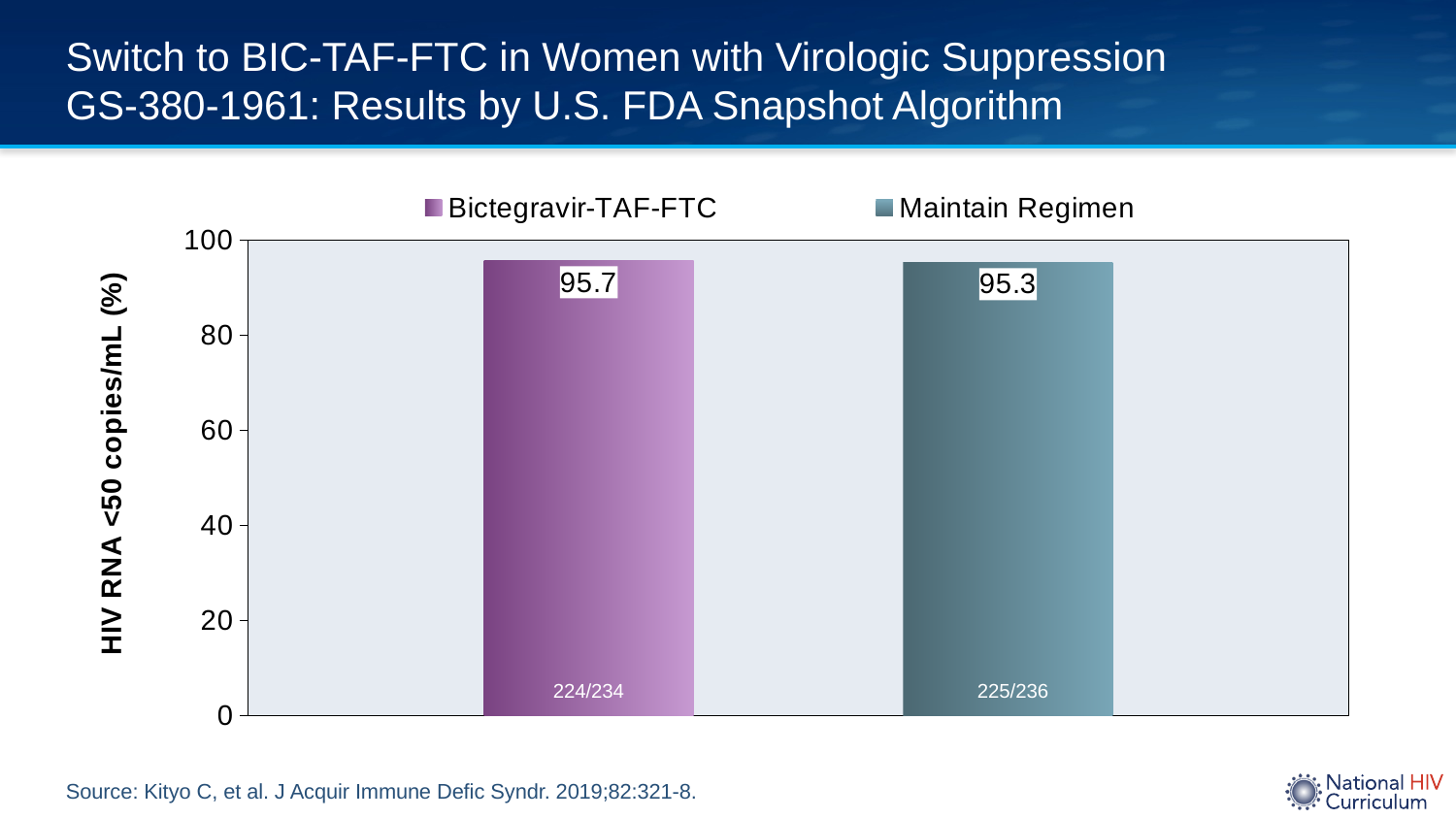
What fraction of participants is shown inside the Bictegravir-TAF-FTC bar? 224/234 Is the value for Maintain Regimen greater or less than 100? less What is the value for Maintain Regimen? 95.3 How many bars are plotted on the chart? 2 What is the label of the y axis? HIV RNA <50 copies/mL (%) How many series does the legend list? 2 What fraction of participants is shown inside the Maintain Regimen bar? 225/236 What is the difference between the Bictegravir-TAF-FTC value and the Maintain Regimen value? 0.4 Is the value for Bictegravir-TAF-FTC greater or less than 80? greater What kind of chart is shown on the slide? Bar chart What is the value for Bictegravir-TAF-FTC? 95.7 Which legend entry is shown in purple? Bictegravir-TAF-FTC